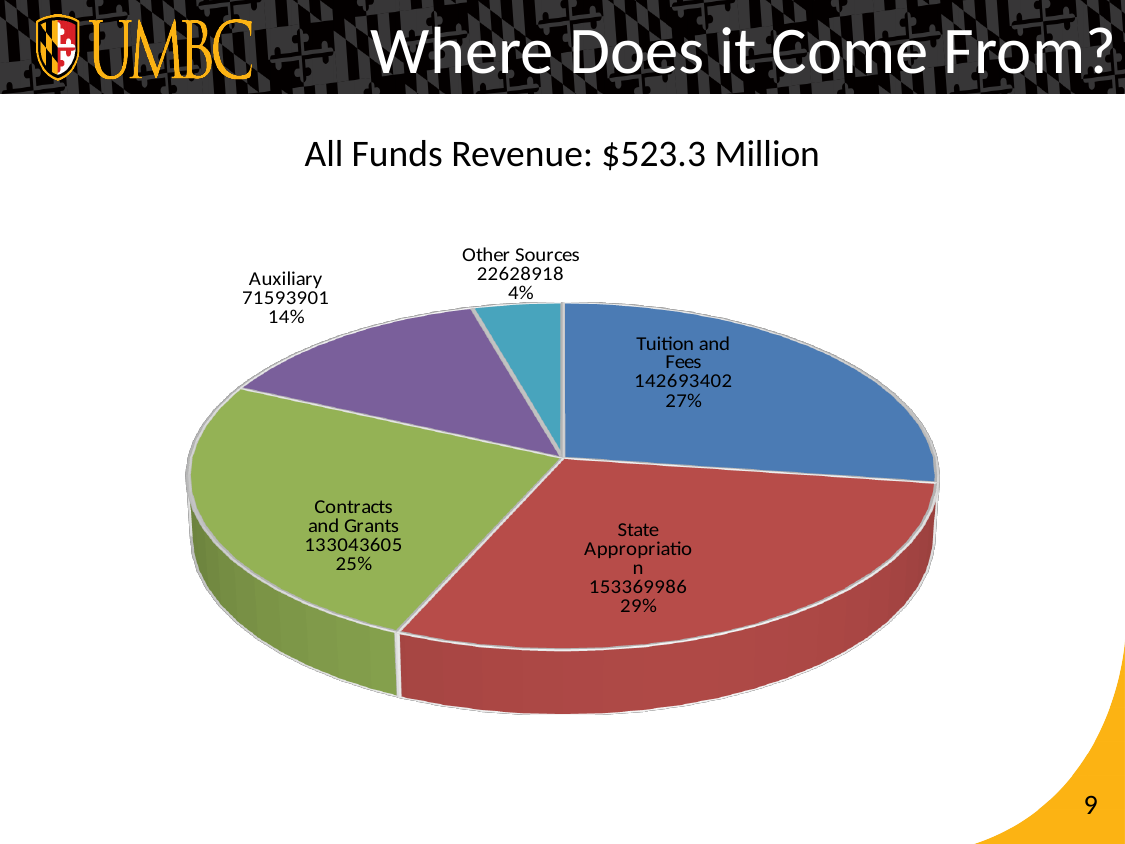
What percentage share does Tuition and Fees represent? 27% Which category has the largest share of the pie? State Appropriation What is the value for Other Sources? 22628918 What percentage share does Auxiliary represent? 14% Which is larger, Auxiliary or Other Sources? Auxiliary What is the value for State Appropriation? 153369986 How many categories are shown in the pie chart? 5 What type of chart is shown on the slide? Pie chart What is the difference between the State Appropriation value and the Tuition and Fees value? 10676584 Which category has the smallest share of the pie? Other Sources What total revenue figure is stated in the chart's subtitle? $523.3 Million What is the value for Contracts and Grants? 133043605